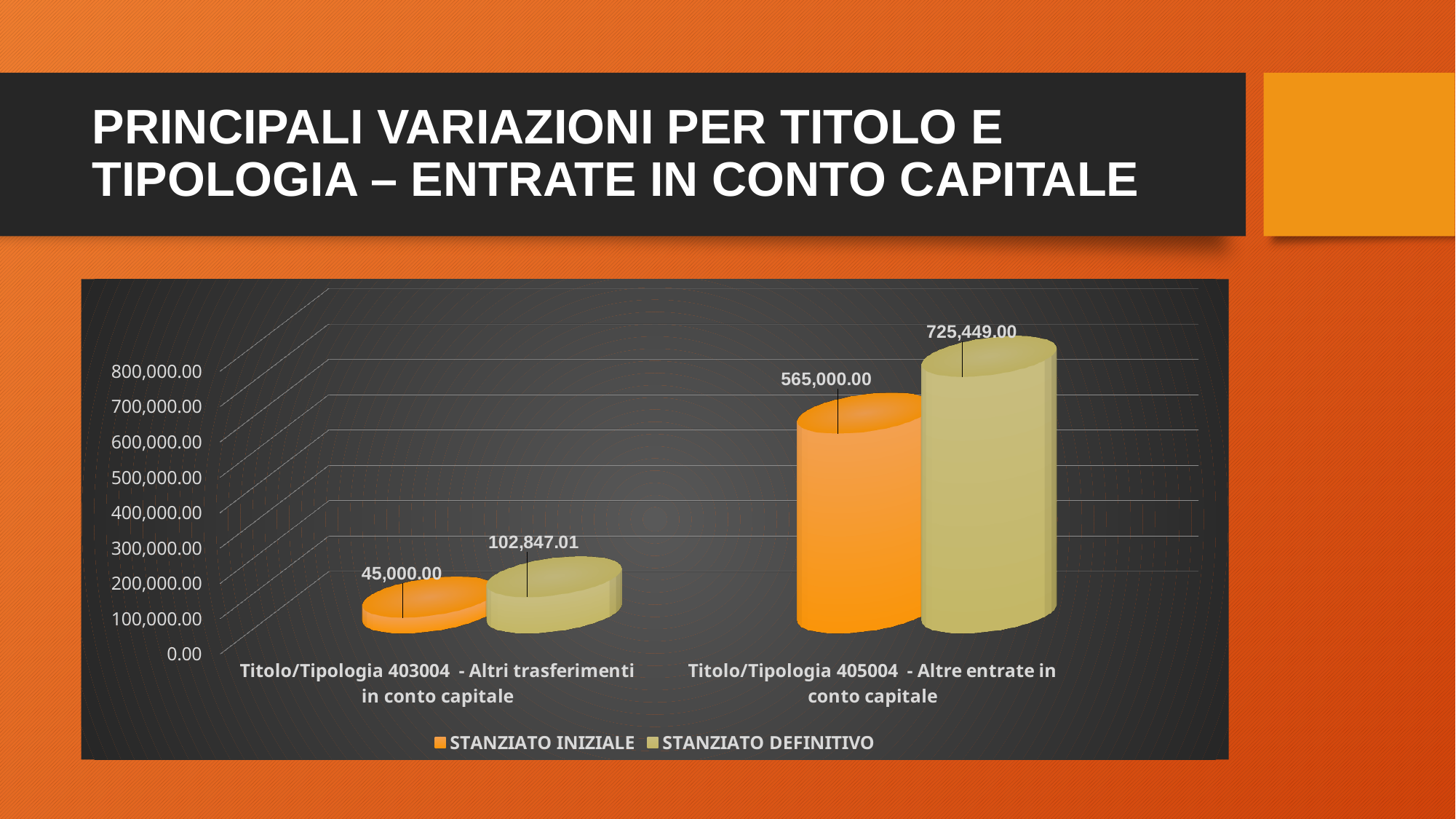
For Titolo/Tipologia 403004, which is larger: STANZIATO INIZIALE or STANZIATO DEFINITIVO? STANZIATO DEFINITIVO What is the STANZIATO INIZIALE value for Titolo/Tipologia 405004 - Altre entrate in conto capitale? 565,000.00 What kind of chart is shown on the slide? Bar chart What is the STANZIATO DEFINITIVO value for Titolo/Tipologia 405004 - Altre entrate in conto capitale? 725,449.00 How many series does the legend list? 2 What is the difference between STANZIATO DEFINITIVO and STANZIATO INIZIALE for Titolo/Tipologia 403004 - Altri trasferimenti in conto capitale? 57,847.01 How many categories are shown on the x axis? 2 What is the STANZIATO INIZIALE value for Titolo/Tipologia 403004 - Altri trasferimenti in conto capitale? 45,000.00 What is the difference between STANZIATO DEFINITIVO and STANZIATO INIZIALE for Titolo/Tipologia 405004 - Altre entrate in conto capitale? 160,449.00 What is the STANZIATO DEFINITIVO value for Titolo/Tipologia 403004 - Altri trasferimenti in conto capitale? 102,847.01 Which category has the lowest STANZIATO INIZIALE value? Titolo/Tipologia 403004 - Altri trasferimenti in conto capitale Which category has the highest STANZIATO DEFINITIVO value? Titolo/Tipologia 405004 - Altre entrate in conto capitale